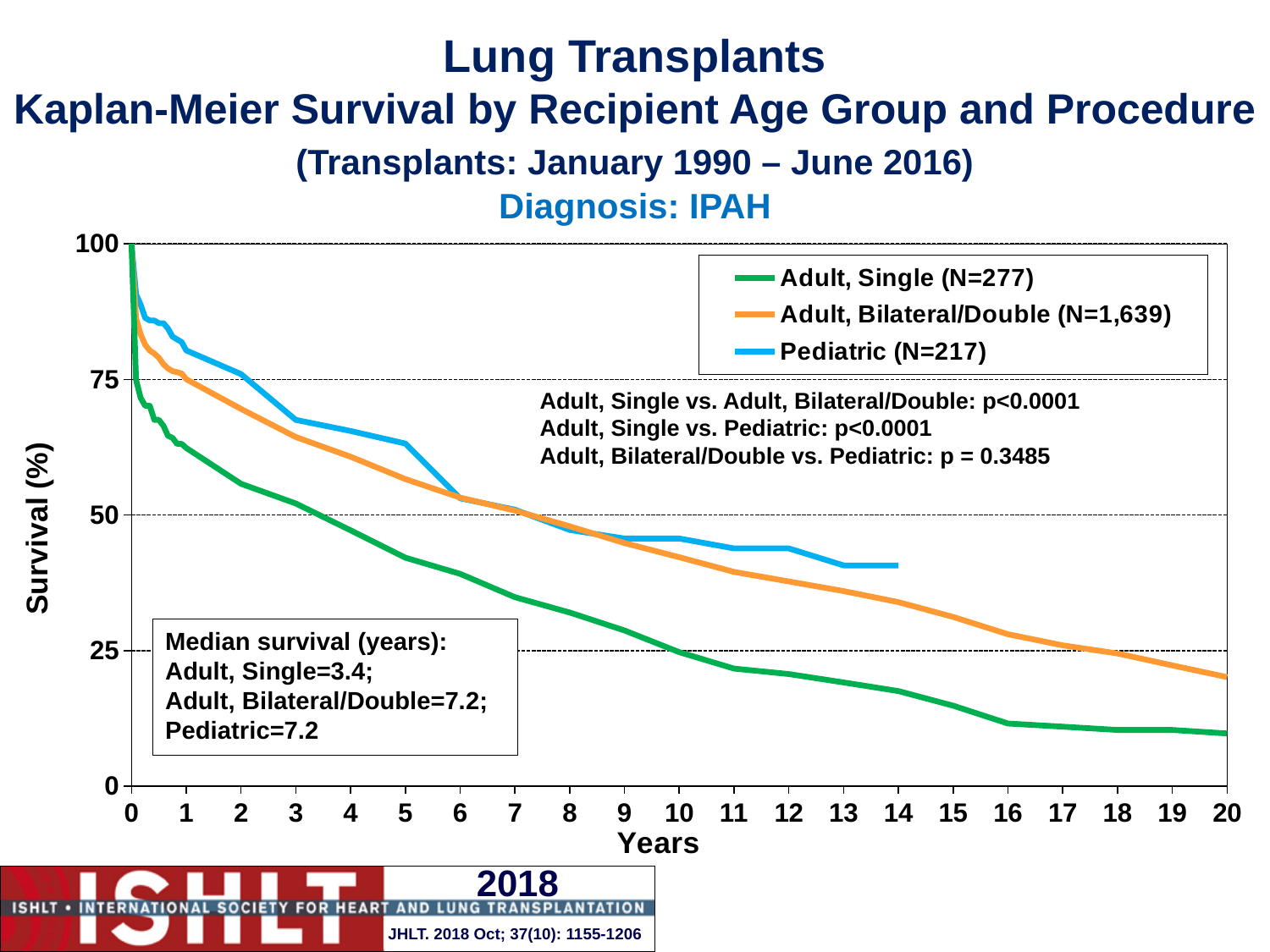
At 15 years, which has higher survival: Adult, Bilateral/Double or Adult, Single? Adult, Bilateral/Double Do the survival curves rise or fall as years increase? fall How many series does the legend list? 3 Is the survival for Adult, Single at 5 years greater or less than 50? less What kind of chart is shown on the slide? line chart What is the N for the Adult, Bilateral/Double group shown in the legend? 1,639 Which group has the largest number of patients (N) in the legend? Adult, Bilateral/Double What is the median survival in years for the Pediatric group? 7.2 What is the median survival in years for the Adult, Single group? 3.4 What is the p-value for Adult, Bilateral/Double vs. Pediatric? p = 0.3485 Which group has the lowest median survival? Adult, Single Is the survival for Pediatric at 5 years greater or less than 50? greater